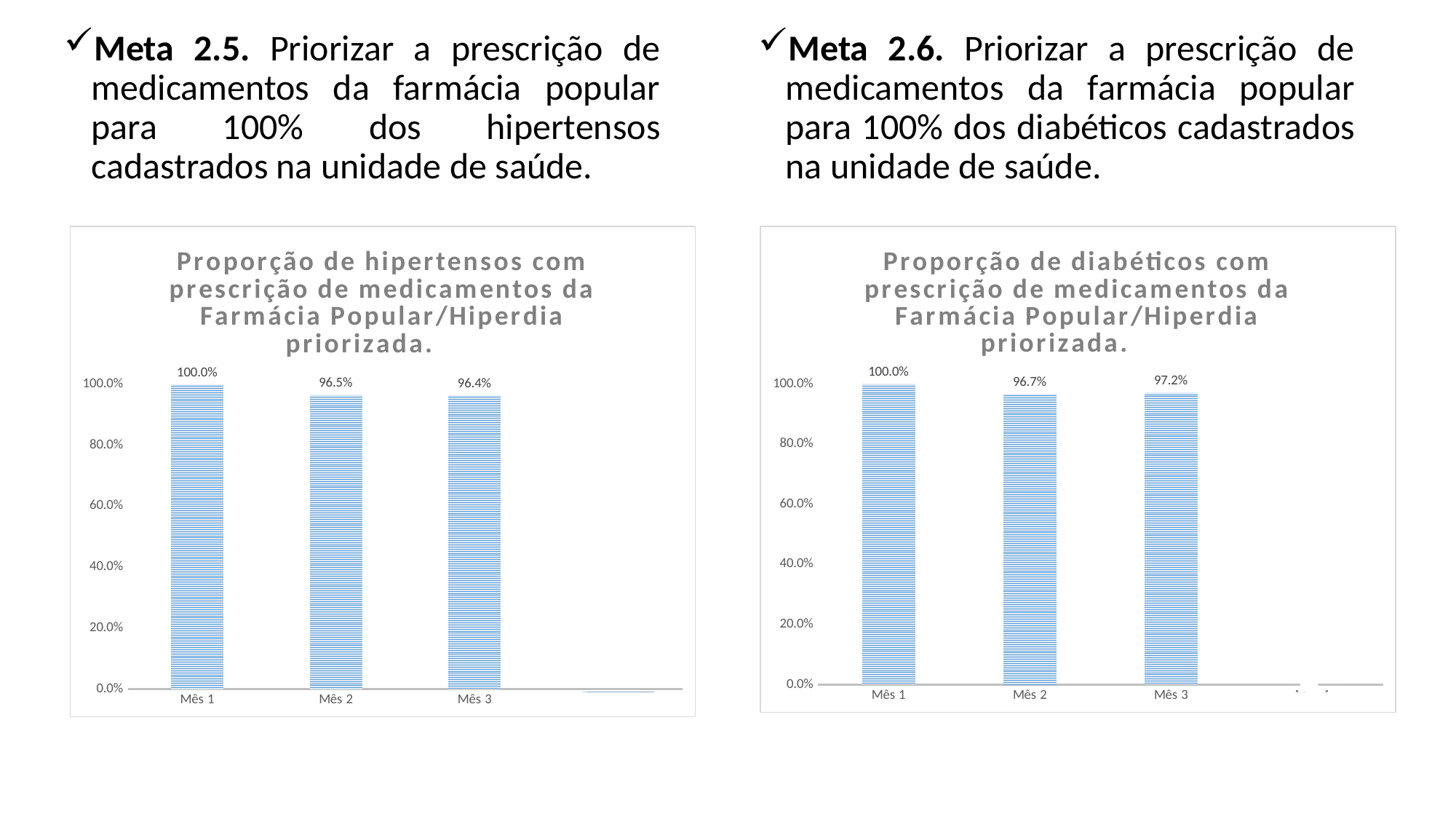
In the right chart (Proporção de diabéticos), which month has the lowest value? Mês 2 In the left chart (Proporção de hipertensos), what is the value for Mês 3? 96.4% In the left chart (Proporção de hipertensos), which month has the highest value? Mês 1 In the left chart (Proporção de hipertensos), is the value for Mês 3 greater or less than 80.0%? greater In the right chart (Proporção de diabéticos), what is the value for Mês 2? 96.7% In the left chart (Proporção de hipertensos), what is the value for Mês 2? 96.5% In the left chart (Proporção de hipertensos), how many months have labelled bars? 3 In the right chart (Proporção de diabéticos), which is larger, the value for Mês 1 or Mês 3? Mês 1 In the right chart (Proporção de diabéticos), what is the value for Mês 3? 97.2% In the left chart (Proporção de hipertensos), what is the difference between the values for Mês 1 and Mês 2? 3.5% What kind of chart is the left chart (Proporção de hipertensos)? Bar chart In the right chart (Proporção de diabéticos), what is the difference between the values for Mês 3 and Mês 2? 0.5%